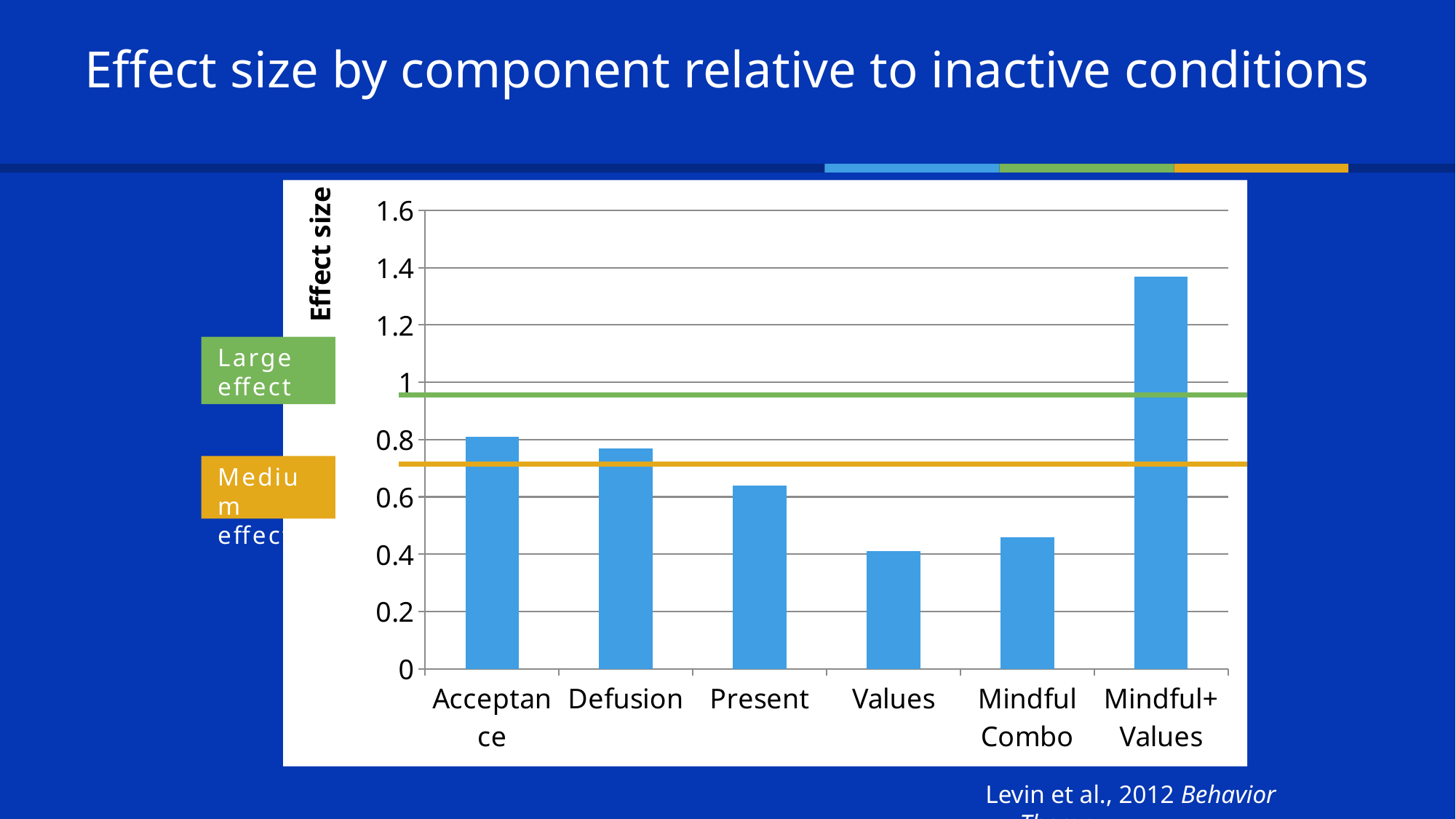
Which has a larger effect size, Acceptance or Present? Acceptance Is the effect size for Present greater or less than 0.8? less Which component has the highest effect size? Mindful+Values Is the effect size for Values greater or less than 0.6? less Is the effect size for Acceptance greater or less than 0.6? greater What is the label on the vertical axis of the chart? Effect size Which has a larger effect size, Defusion or Values? Defusion Which component has the lowest effect size? Values What kind of chart is shown on the slide? bar chart How many components (categories) are plotted on the x axis? 6